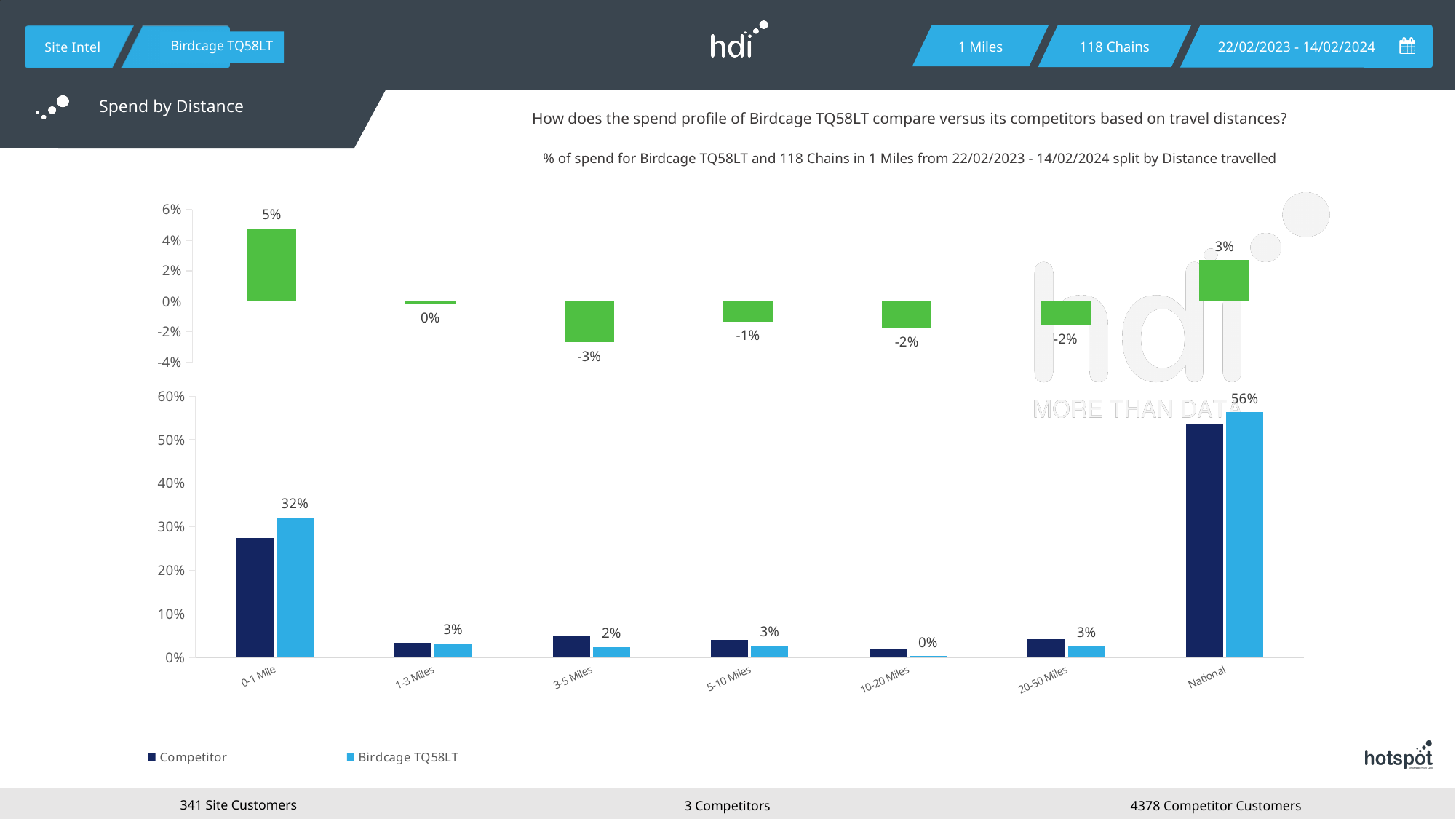
What kind of chart is the bottom chart? bar chart In the top chart, what is the value for 3-5 Miles? -3% In the top chart, which distance band has the lowest value? 3-5 Miles In the bottom chart, what is the Birdcage TQ58LT value for 0-1 Mile? 32% How many series does the legend of the bottom chart list? 2 How many distance categories are shown on the x axis of the bottom chart? 7 In the bottom chart, what is the Birdcage TQ58LT value for National? 56% In the top chart, which distance band has the highest value? 0-1 Mile In the bottom chart, for 0-1 Mile, which is larger: Competitor or Birdcage TQ58LT? Birdcage TQ58LT In the bottom chart, is the Competitor value for National greater or less than 50%? greater In the bottom chart, what is the difference between the Birdcage TQ58LT values for National and 0-1 Mile? 24% In the top chart, what is the value for 0-1 Mile? 5%